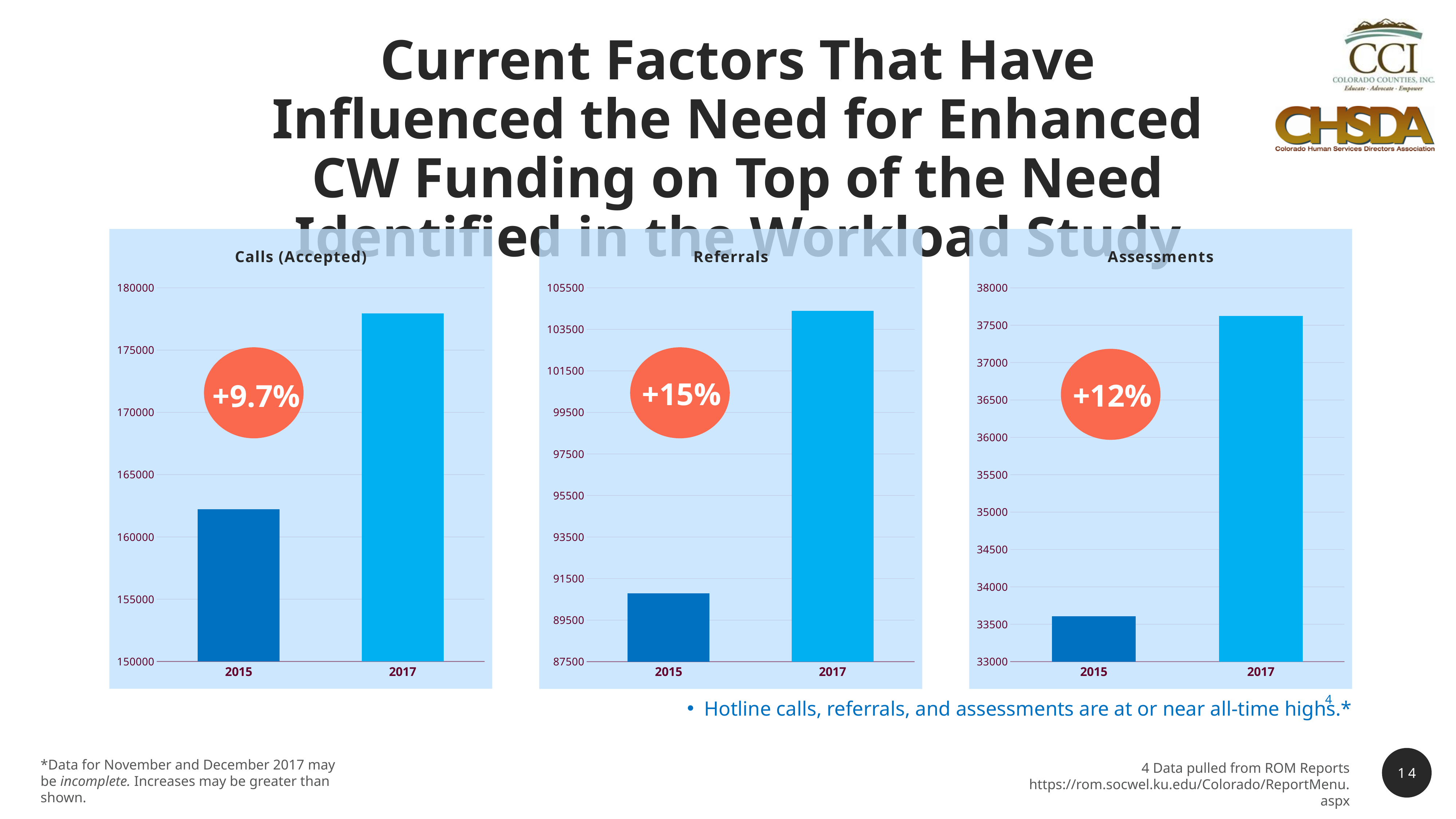
In the Referrals chart, is the value for 2017 greater or less than 103500? greater How many categories are shown on the x axis of the Referrals chart? 2 What percentage increase is shown in the circle on the Referrals chart? +15% Do the values in the Assessments chart rise or fall from 2015 to 2017? rise In the Calls (Accepted) chart, is the value for 2015 greater or less than 160000? greater In the Calls (Accepted) chart, which year has the higher value, 2015 or 2017? 2017 What kind of chart is the Calls (Accepted) chart? bar chart In the Assessments chart, is the value for 2017 greater or less than 37000? greater In the Assessments chart, which year has the lowest value? 2015 In the Referrals chart, which year has the highest value? 2017